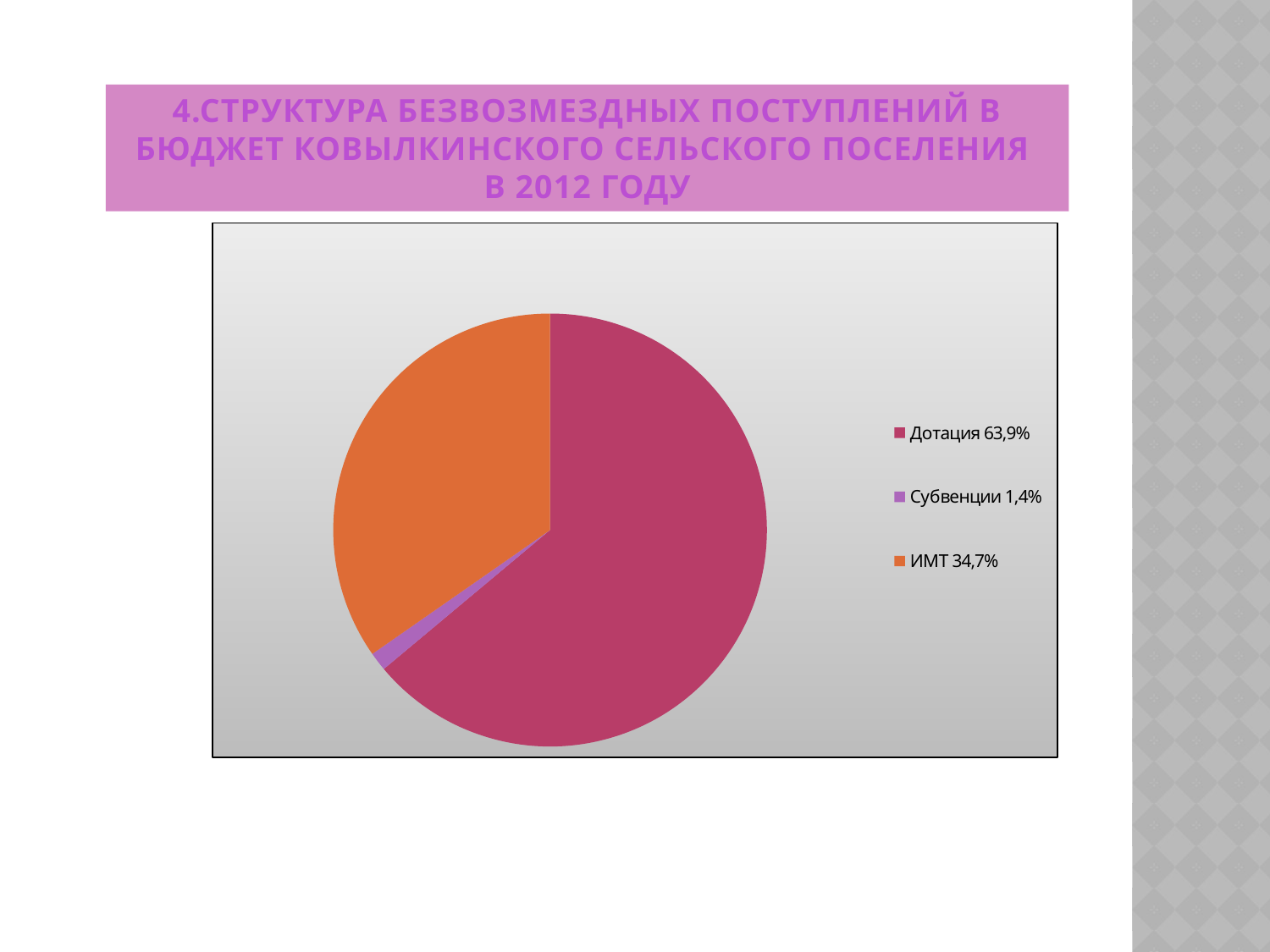
What is the difference in percentage points between the Дотация share and the ИМТ share? 29,2 What share of the pie does ИМТ represent? 34,7% Which category has the largest slice of the pie? Дотация What kind of chart is shown on the slide? pie chart Which category has the smallest slice of the pie? Субвенции What colour is the slice for ИМТ? orange How many entries does the legend list? 3 How many slices does the pie chart have? 3 Which year does the chart title refer to? 2012 Which is larger, the share for ИМТ or the share for Субвенции? ИМТ What share of the pie does Дотация represent? 63,9% What share of the pie does Субвенции represent? 1,4%